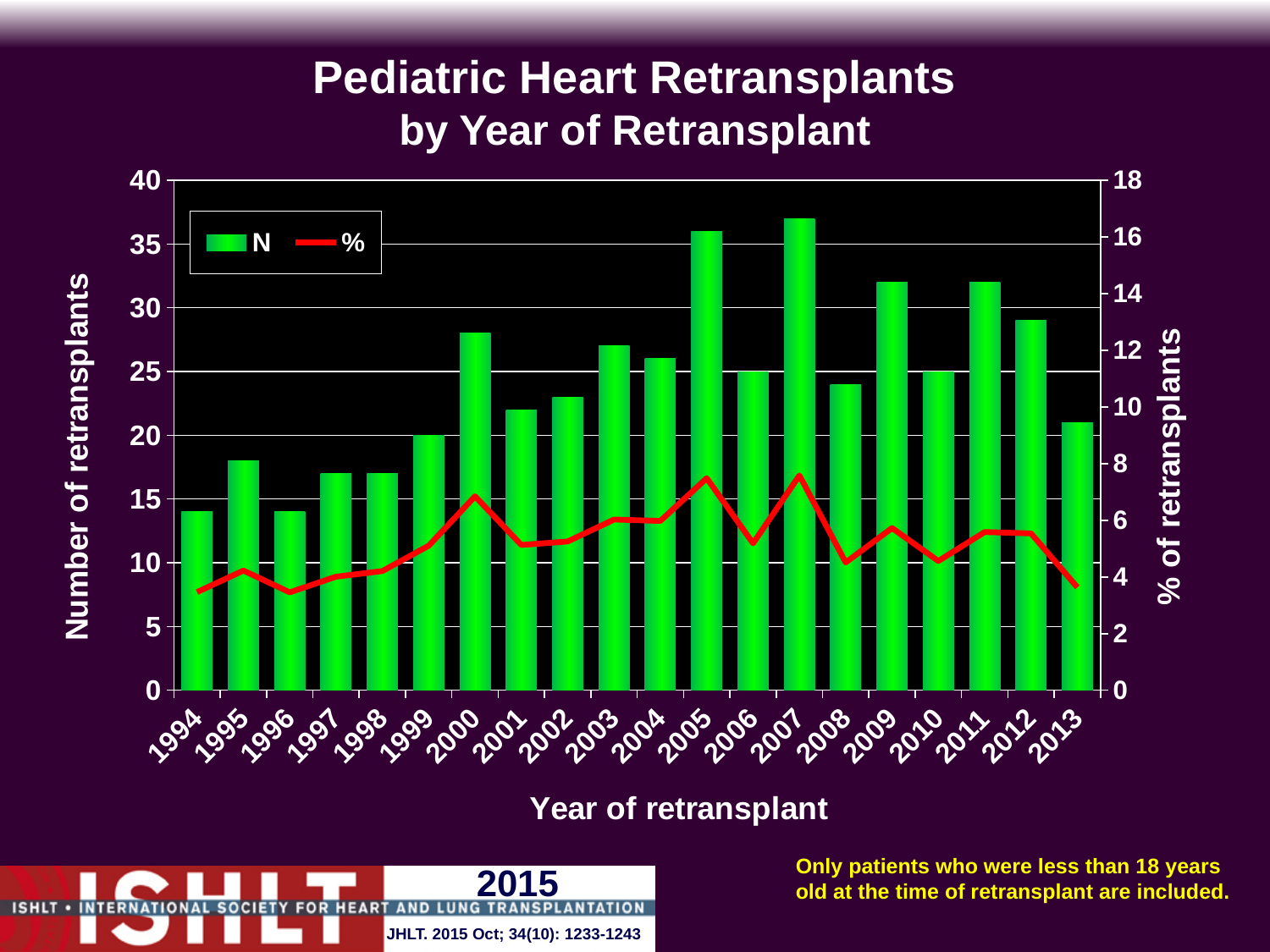
What type of chart is used to show the number of retransplants? bar chart Which year had more retransplants, 2005 or 2006? 2005 Which year had more retransplants, 2000 or 2001? 2000 How many years are shown on the x axis? 20 What are the two entries in the legend? N and % What is the label of the right-hand y axis? % of retransplants Is the number of retransplants in 1994 greater or less than 15? less How many series does the legend list? 2 Is the number of retransplants in 2012 greater or less than 30? less Is the number of retransplants in 2005 greater or less than 35? greater Does the % of retransplants line rise or fall from 2012 to 2013? fall